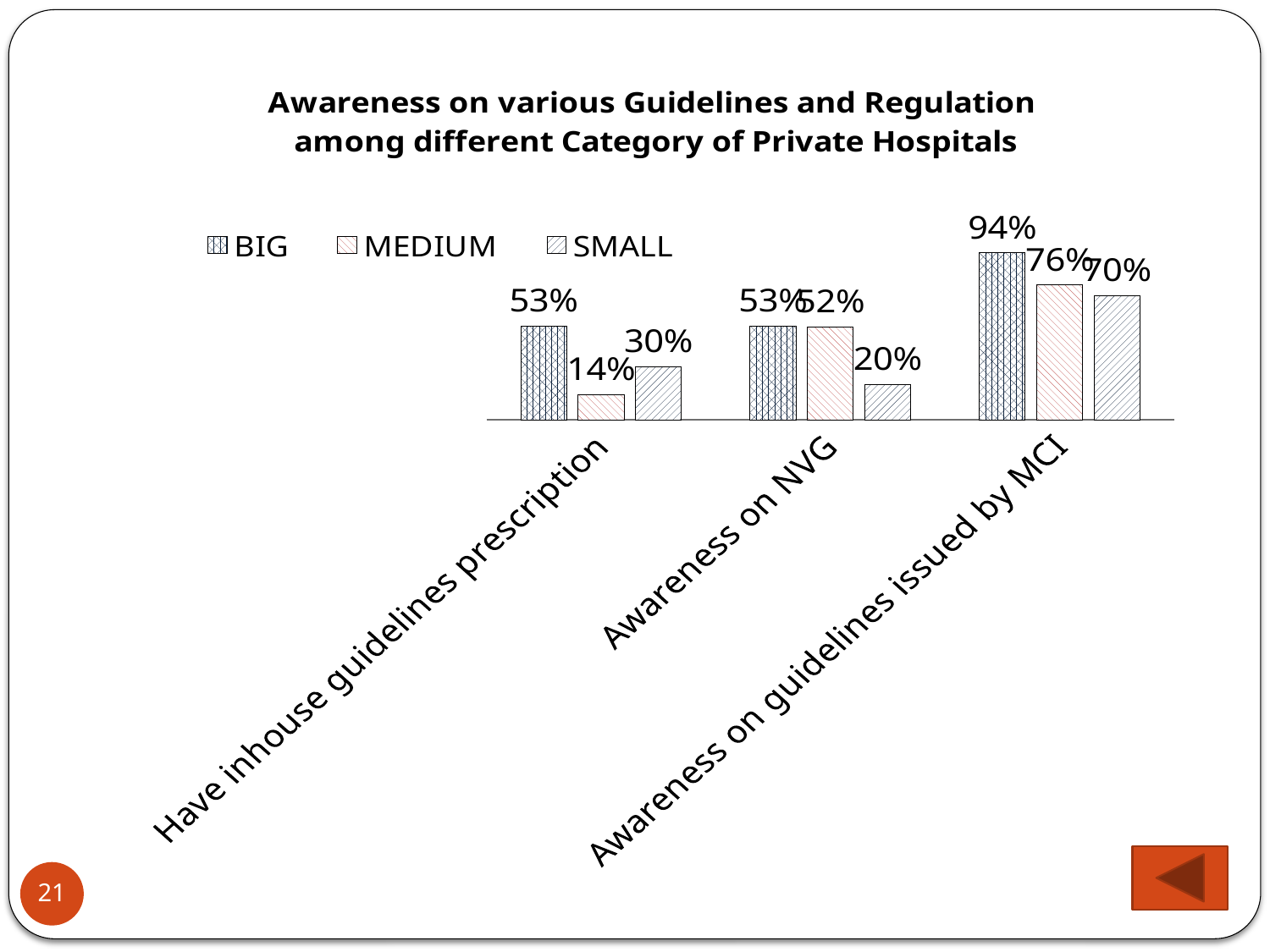
What is the difference between the BIG and MEDIUM values for 'Awareness on guidelines issued by MCI'? 18% What is the value for MEDIUM in the 'Have inhouse guidelines prescription' category? 14% What is the value for SMALL in the 'Awareness on guidelines issued by MCI' category? 70% Which hospital category has the highest value for 'Awareness on guidelines issued by MCI'? BIG How many series does the legend list? 3 What is the value for BIG in the 'Awareness on guidelines issued by MCI' category? 94% Which is larger for SMALL hospitals: 'Have inhouse guidelines prescription' or 'Awareness on NVG'? Have inhouse guidelines prescription How many categories are shown on the x axis? 3 Which hospital category has the lowest value for 'Have inhouse guidelines prescription'? MEDIUM What is the value for SMALL in the 'Awareness on NVG' category? 20% What kind of chart is shown on the slide? Bar chart What is the value for BIG in the 'Have inhouse guidelines prescription' category? 53%